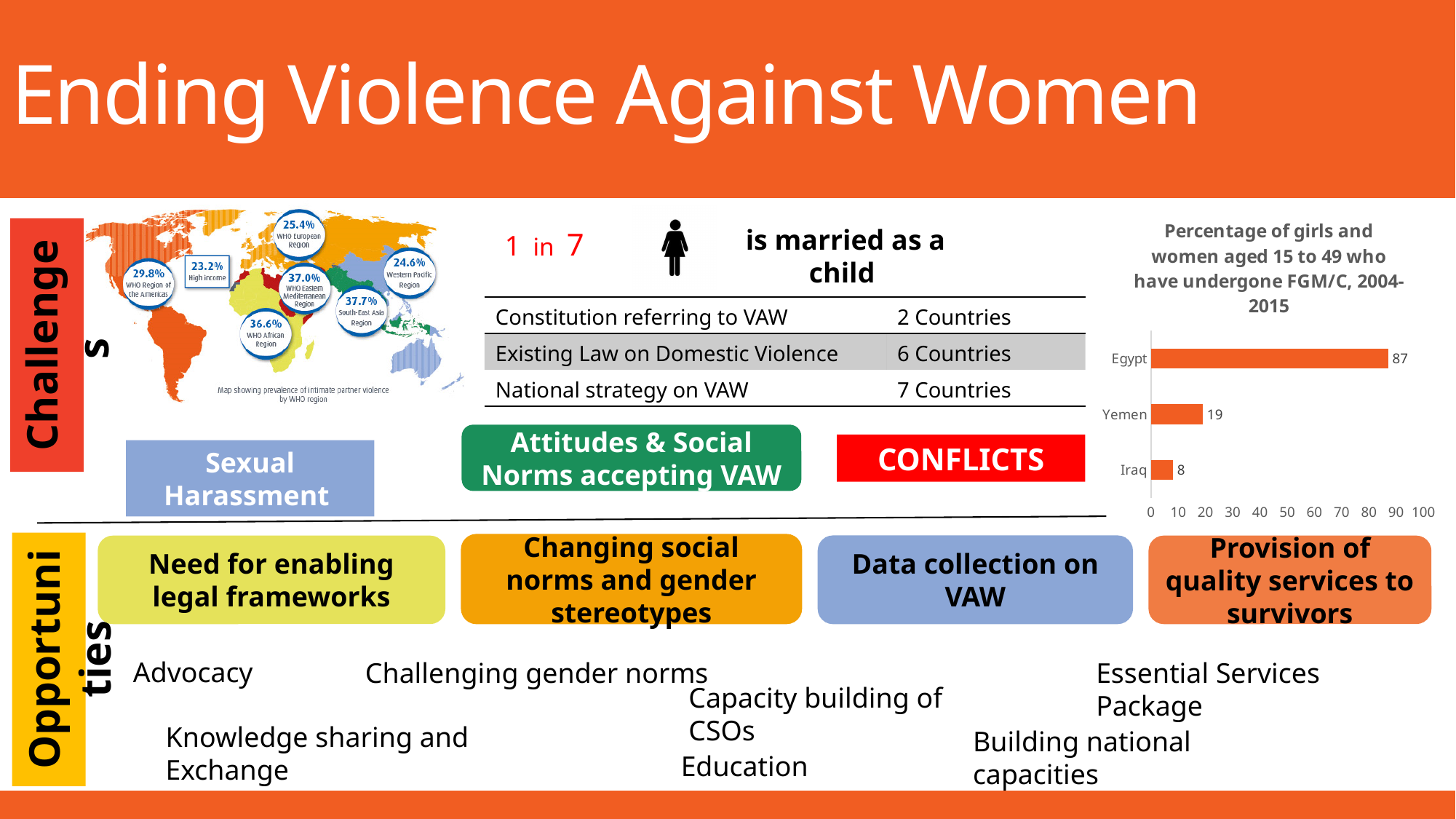
In the bar chart on the right, what is the value for Yemen? 19 In the bar chart on the right, what is the difference between the values for Yemen and Iraq? 11 In the bar chart on the right, what is the value for Iraq? 8 What kind of chart is shown on the right of the slide? Bar chart In the bar chart on the right, which is larger, the value for Yemen or the value for Iraq? Yemen In the bar chart on the right, is the value for Egypt greater or less than 80? greater How many countries are shown in the bar chart on the right? 3 In the bar chart on the right, which country has the lowest value? Iraq In the bar chart on the right, what is the value for Egypt? 87 In the bar chart on the right, which country has the highest value? Egypt In the bar chart on the right, what is the difference between the values for Egypt and Yemen? 68 What is the title of the bar chart on the right of the slide? Percentage of girls and women aged 15 to 49 who have undergone FGM/C, 2004-2015